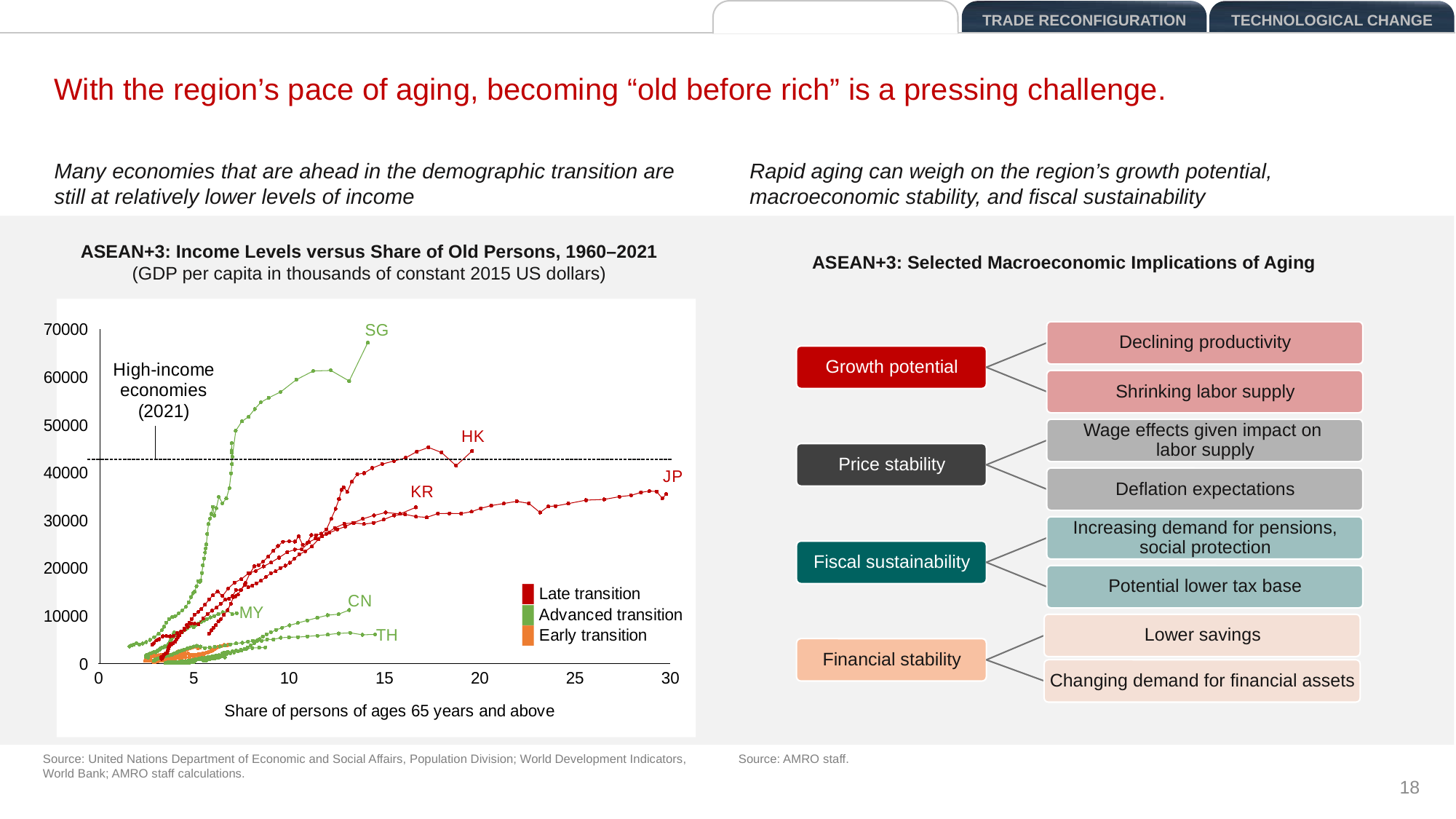
What is the x-axis label of the 'Income Levels versus Share of Old Persons' chart? Share of persons of ages 65 years and above In the 'Income Levels versus Share of Old Persons' chart, is the peak GDP per capita of HK greater or less than 40000? greater In the 'Income Levels versus Share of Old Persons' chart, which labeled economy reaches the highest share of persons aged 65 and above? JP How many series does the legend of the 'Income Levels versus Share of Old Persons' chart list? 3 In the 'Income Levels versus Share of Old Persons' chart, is the latest GDP per capita of JP greater or less than 40000? less What kind of chart is 'ASEAN+3: Income Levels versus Share of Old Persons, 1960–2021'? scatter chart What are the three legend entries in the 'Income Levels versus Share of Old Persons' chart? Late transition, Advanced transition, Early transition In the 'Income Levels versus Share of Old Persons' chart, which labeled economy reaches the highest GDP per capita? SG In the 'Income Levels versus Share of Old Persons' chart, is the highest GDP per capita reached by TH greater or less than 10000? less In the 'Income Levels versus Share of Old Persons' chart, which reaches a higher GDP per capita, CN or TH? CN How many economies are labeled by name in the 'Income Levels versus Share of Old Persons' chart? 7